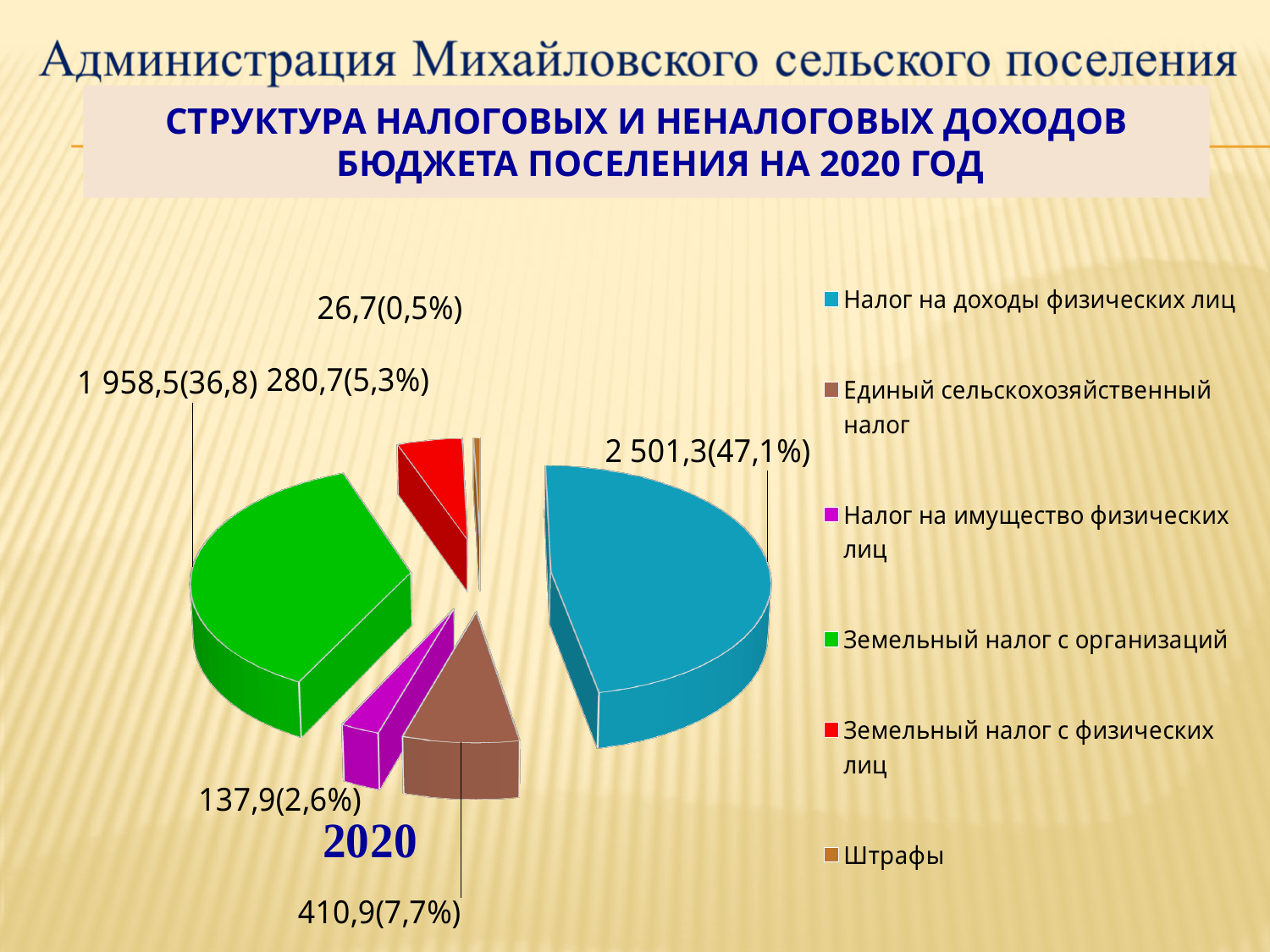
Which is larger: Земельный налог с физических лиц or Единый сельскохозяйственный налог? Единый сельскохозяйственный налог Which category has the largest slice of the pie? Налог на доходы физических лиц How many slices does the pie chart have? 6 What value is shown for Налог на доходы физических лиц? 2 501,3(47,1%) Which category has the smallest slice of the pie? Штрафы What kind of chart is shown on the slide? Pie chart What value is shown for Земельный налог с организаций? 1 958,5(36,8) What share of the pie does Налог на имущество физических лиц represent? 2,6% What is the difference between the values for Налог на доходы физических лиц and Земельный налог с организаций? 542,8 What value is shown for Штрафы? 26,7(0,5%) What value is shown for Единый сельскохозяйственный налог? 410,9(7,7%) How many entries does the legend list? 6